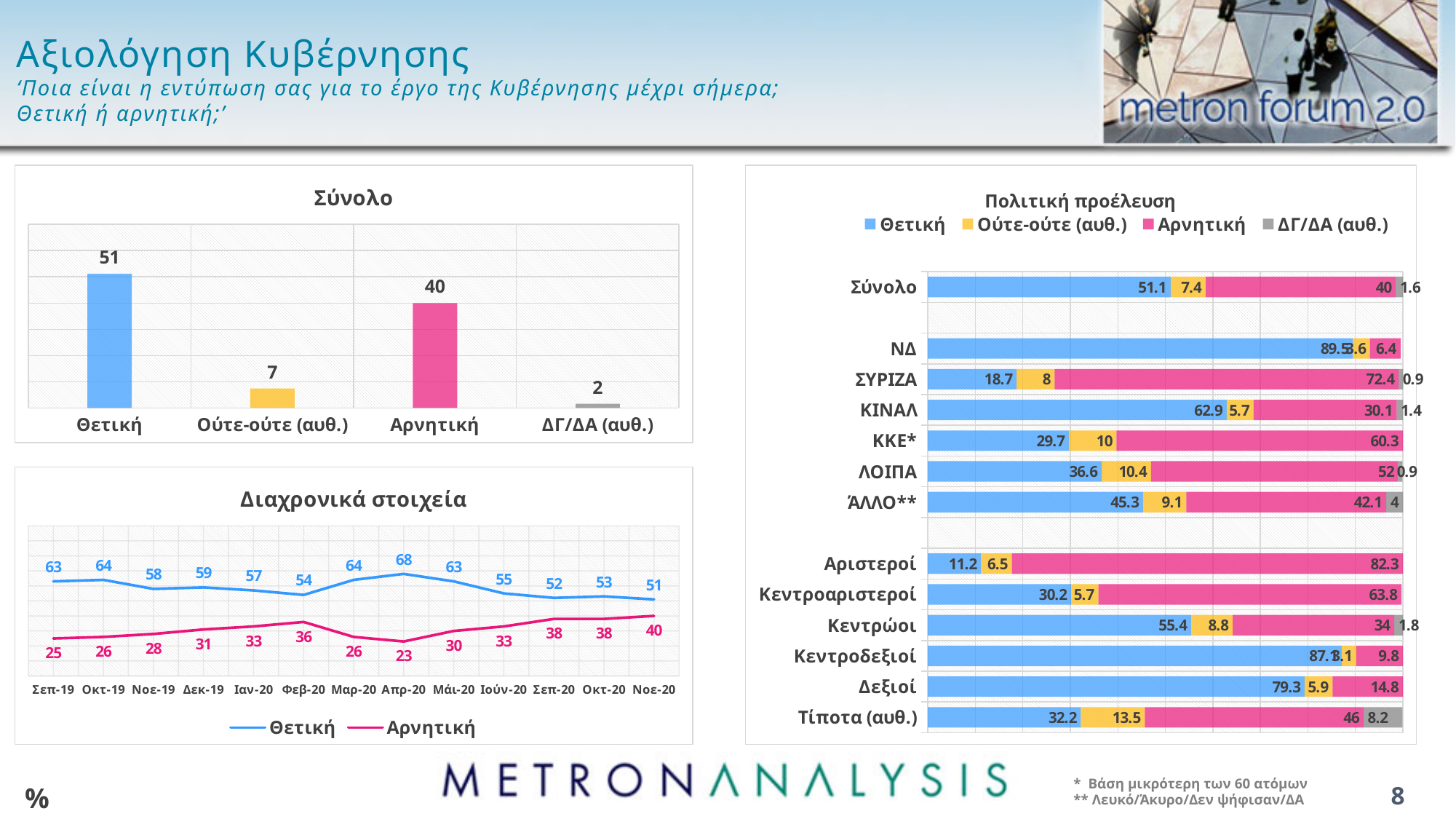
In the 'Διαχρονικά στοιχεία' line chart, how many series does the legend list? 2 In the 'Πολιτική προέλευση' chart, what is the Θετική value for Δεξιοί? 79.3 In the 'Πολιτική προέλευση' chart, which is larger for Τίποτα (αυθ.): Θετική or Αρνητική? Αρνητική In the 'Διαχρονικά στοιχεία' line chart, what is the Αρνητική value for Νοε-20? 40 In the 'Σύνολο' bar chart, what is the value for Θετική? 51 In the 'Διαχρονικά στοιχεία' line chart, what is the Θετική value for Απρ-20? 68 In the 'Σύνολο' bar chart, what is the difference between Θετική and Αρνητική? 11 In the 'Σύνολο' bar chart, which category has the lowest value? ΔΓ/ΔΑ (αυθ.) What kind of chart is the 'Σύνολο' chart? bar chart In the 'Πολιτική προέλευση' chart, what is the Αρνητική value for ΣΥΡΙΖΑ? 72.4 In the 'Διαχρονικά στοιχεία' line chart, does the Αρνητική series rise or fall from Απρ-20 to Νοε-20? rise In the 'Διαχρονικά στοιχεία' line chart, how many time points are shown on the x axis? 13